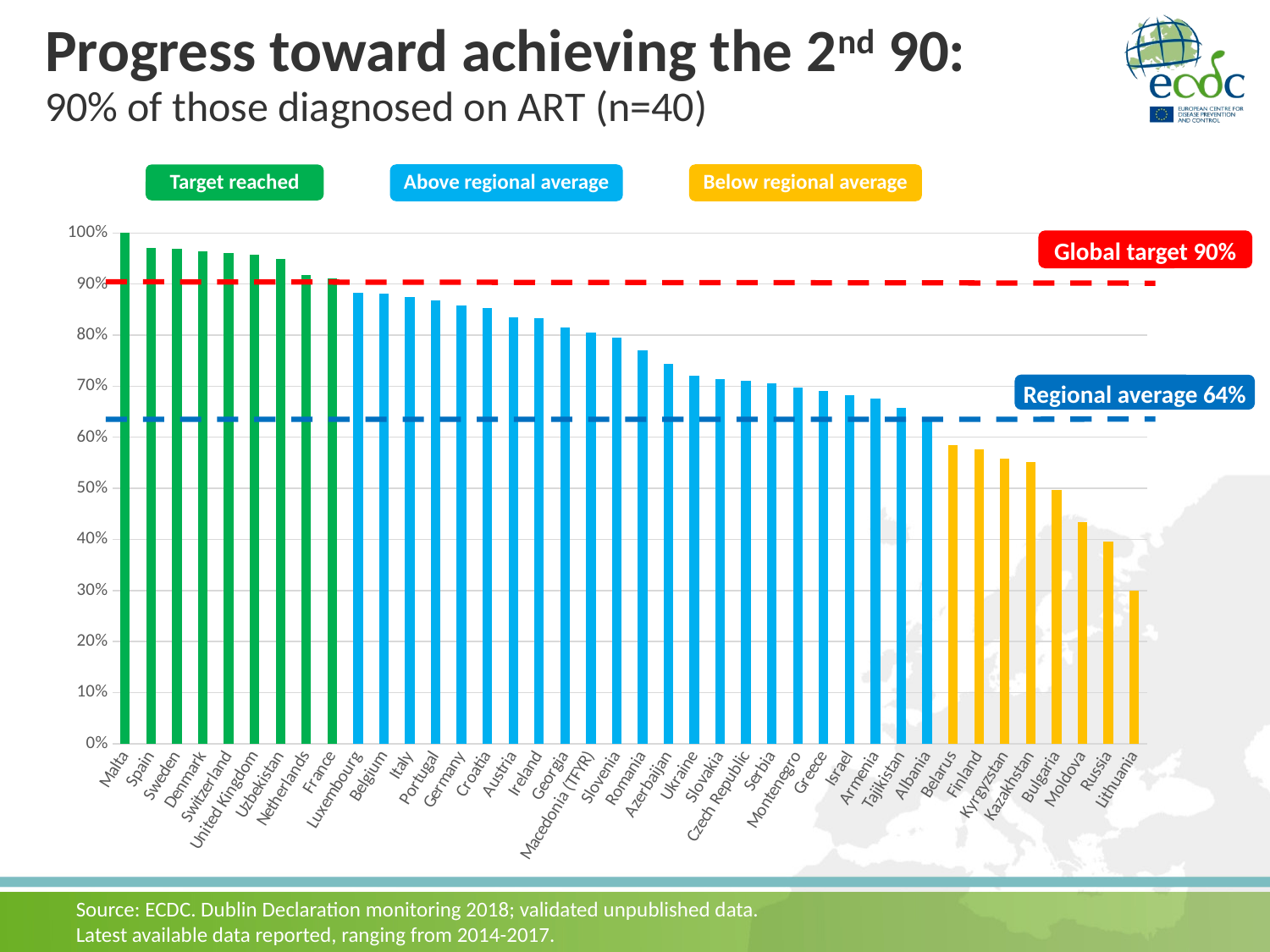
Which country has the highest value in the chart? Malta Is the value for Belgium greater or less than 90%? less Do the values rise or fall moving from left to right along the x axis? fall How many categories does the legend list? 3 How many countries are plotted in the chart? 40 Is the value for Spain greater or less than 90%? greater What is the value for Malta? 100% Which is larger, the value for Spain or the value for Belgium? Spain What kind of chart is shown on the slide? bar chart Which country has the lowest value in the chart? Lithuania Is the value for Moldova greater or less than 50%? less What value is given for the global target line? 90%